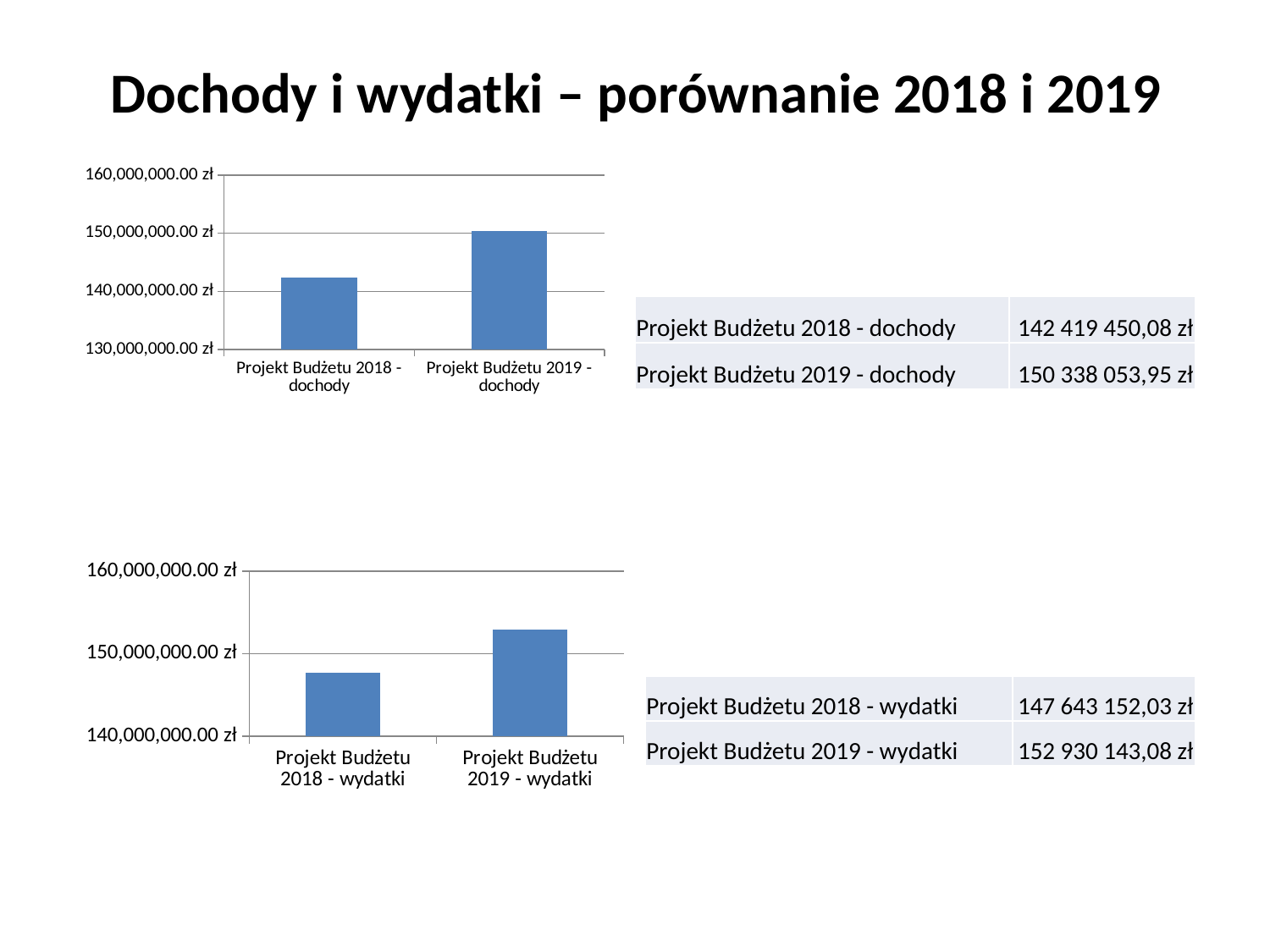
How many bars does the bottom chart (wydatki) show? 2 On the top chart (dochody), what is the difference between the 2019 and 2018 values? 7 918 603,87 zł What kind of chart is the top chart (dochody)? bar chart On the bottom chart (wydatki), what is the value for Projekt Budżetu 2018 - wydatki? 147 643 152,03 zł On the bottom chart (wydatki), what is the difference between the 2019 and 2018 values? 5 286 991,05 zł On the top chart (dochody), is the value for Projekt Budżetu 2018 - dochody greater or less than 140,000,000.00 zł? greater On the top chart (dochody), which category has the higher value? Projekt Budżetu 2019 - dochody On the bottom chart (wydatki), is the value for Projekt Budżetu 2018 - wydatki greater or less than 150,000,000.00 zł? less On the top chart (dochody), what is the value for Projekt Budżetu 2018 - dochody? 142 419 450,08 zł On the top chart (dochody), what is the value for Projekt Budżetu 2019 - dochody? 150 338 053,95 zł On the bottom chart (wydatki), which category has the lower value? Projekt Budżetu 2018 - wydatki On the bottom chart (wydatki), what is the value for Projekt Budżetu 2019 - wydatki? 152 930 143,08 zł